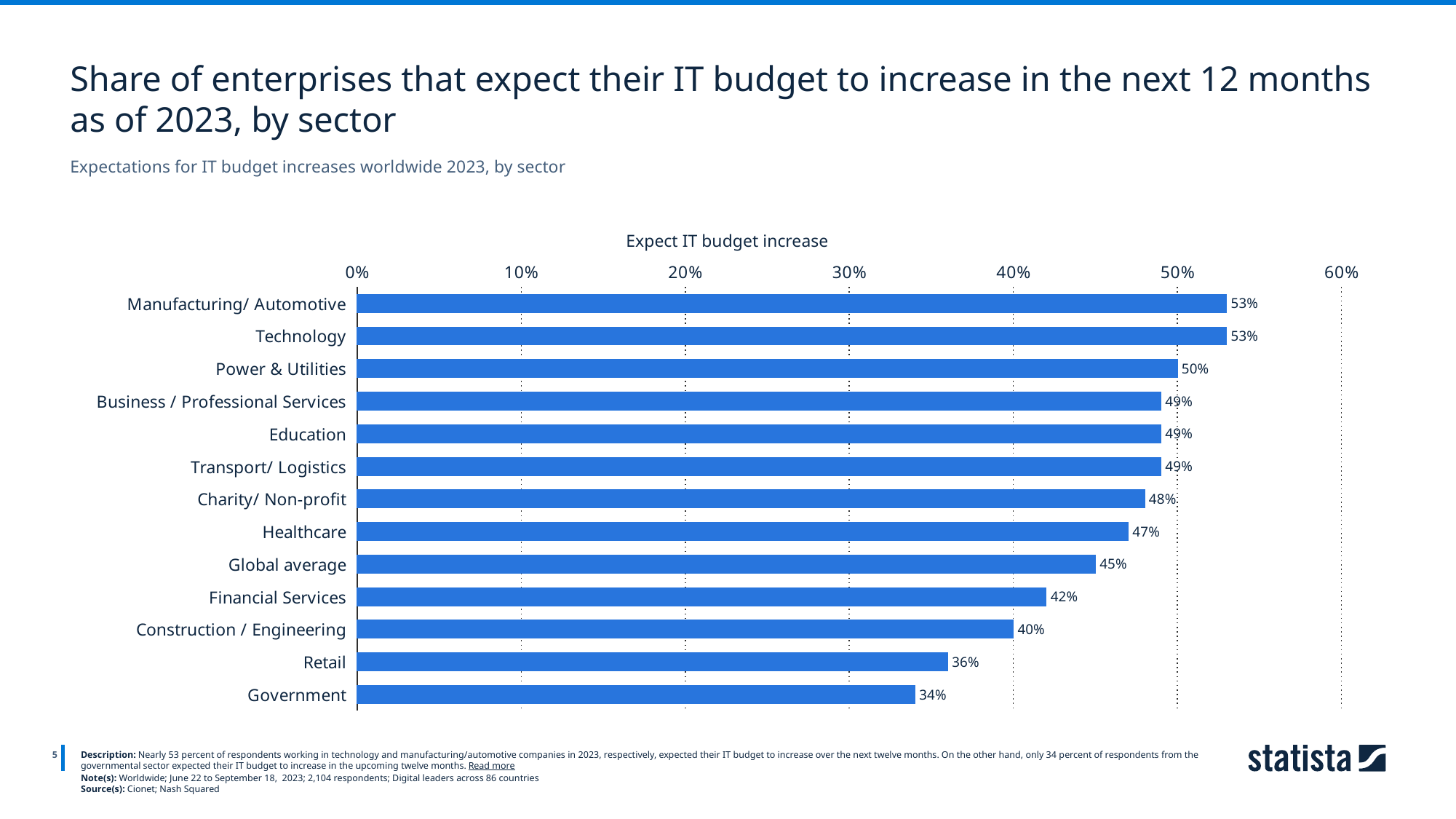
What share of Power & Utilities enterprises expect their IT budget to increase? 50% What is the Global average share of enterprises expecting an IT budget increase? 45% What is the value shown for Healthcare? 47% What is the difference between the values for Technology and Government? 19% Is the value for Charity/ Non-profit greater or less than 40%? greater How many sectors (bars) are shown in the chart? 13 What is the highest value shown on the horizontal axis? 60% What kind of chart is shown on the slide? Bar chart Which is larger, the value for Construction / Engineering or the value for Retail? Construction / Engineering Which sector has the lowest share of enterprises expecting an IT budget increase? Government What is the difference between the values for Financial Services and Retail? 6% What is the label shown above the chart's axis? Expect IT budget increase